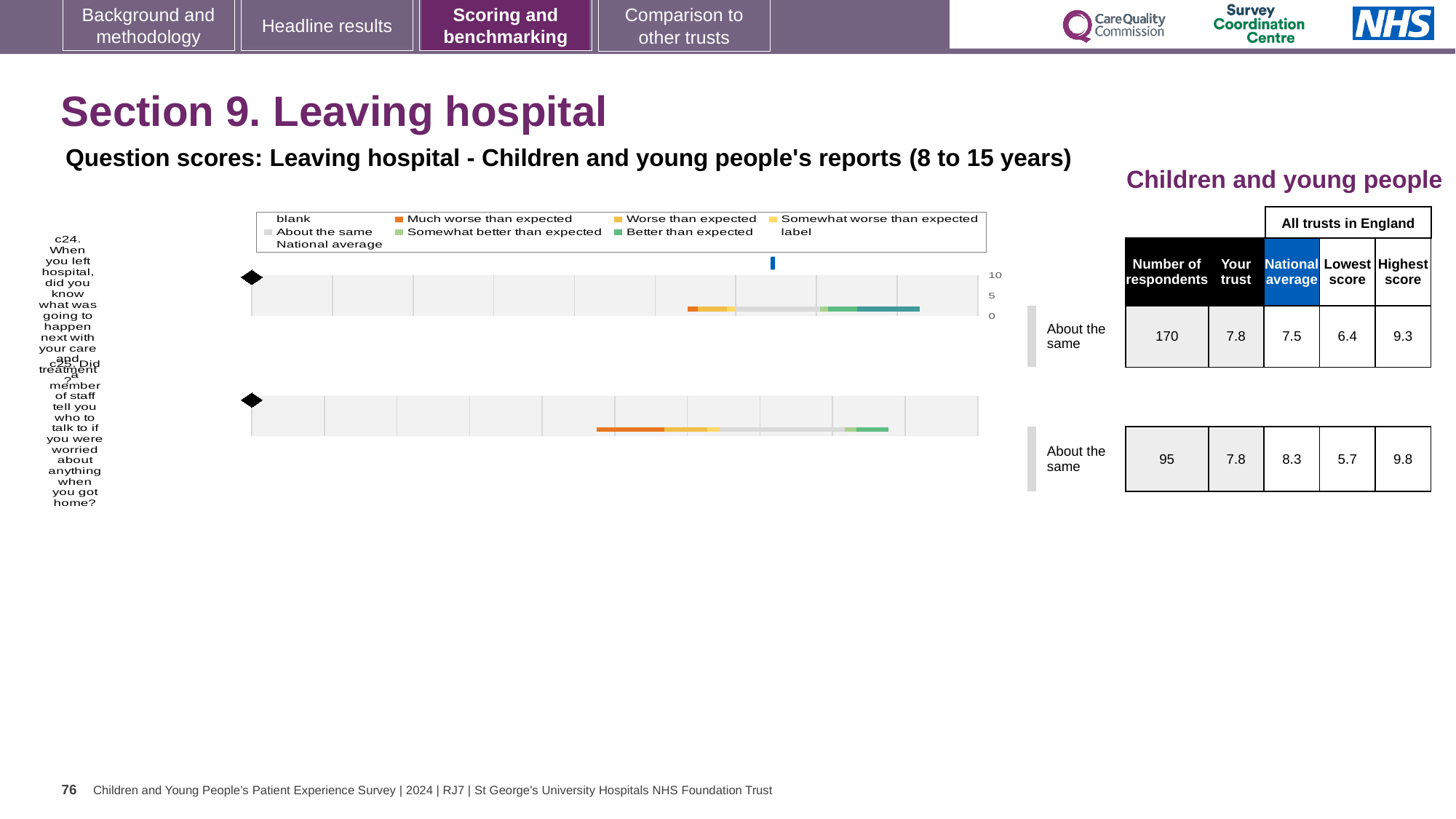
How many respondents answered question c24? 170 Which question has more respondents, c24 or c25? c24 What is the national average score for question c25? 8.3 For question c25, what is the difference between the highest score and the lowest score across all trusts in England? 4.1 What is the subtitle above the chart? Question scores: Leaving hospital - Children and young people's reports (8 to 15 years) What is the 'Your trust' score for question c24? 7.8 Which colour does the legend use for 'Much worse than expected'? orange What kind of chart is used to show the question scores for c24 and c25? bar chart How many questions (bars) are plotted in the chart? 2 What benchmark category is shown for question c25? About the same For question c24, which is higher: the 'Your trust' score or the national average? Your trust For question c24, what is the difference between the highest score and the lowest score across all trusts in England? 2.9